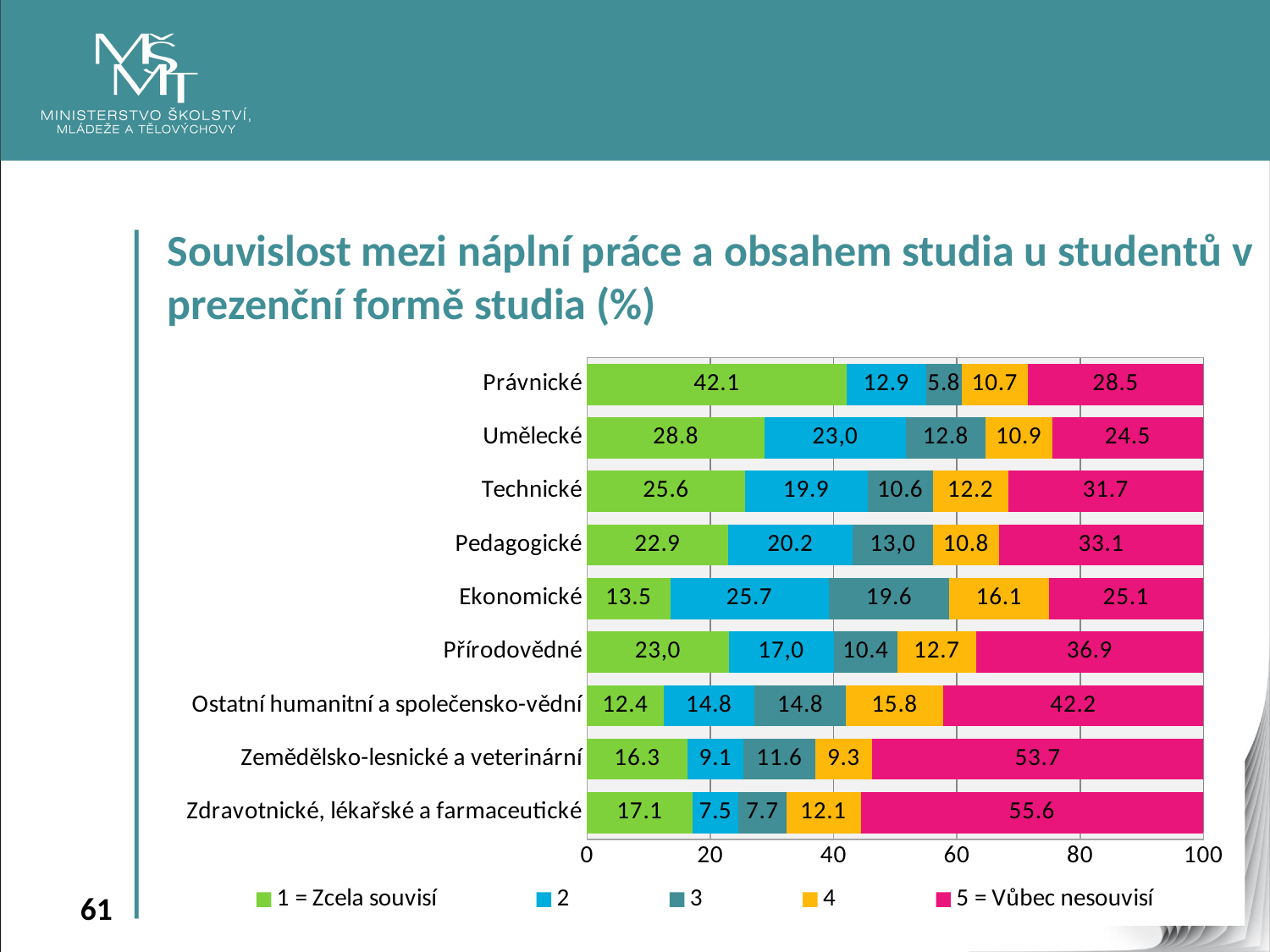
How many categories are shown on the chart? 9 Which category has the highest value for "1 = Zcela souvisí"? Právnické Which is larger: the "5 = Vůbec nesouvisí" value for Technické or for Pedagogické? Pedagogické Which category has the highest value for "5 = Vůbec nesouvisí"? Zdravotnické, lékařské a farmaceutické What is the value for series 4 in the Ostatní humanitní a společensko-vědní category? 15.8 What is the value for series 3 in the Ekonomické category? 19.6 Which category has the lowest value for "1 = Zcela souvisí"? Ostatní humanitní a společensko-vědní What is the difference between the "1 = Zcela souvisí" value and the "5 = Vůbec nesouvisí" value for Právnické? 13.6 What kind of chart is shown on the slide? Stacked bar chart What is the value for "5 = Vůbec nesouvisí" in the Zemědělsko-lesnické a veterinární category? 53.7 How many series does the legend list? 5 What is the value for "1 = Zcela souvisí" in the Právnické category? 42.1